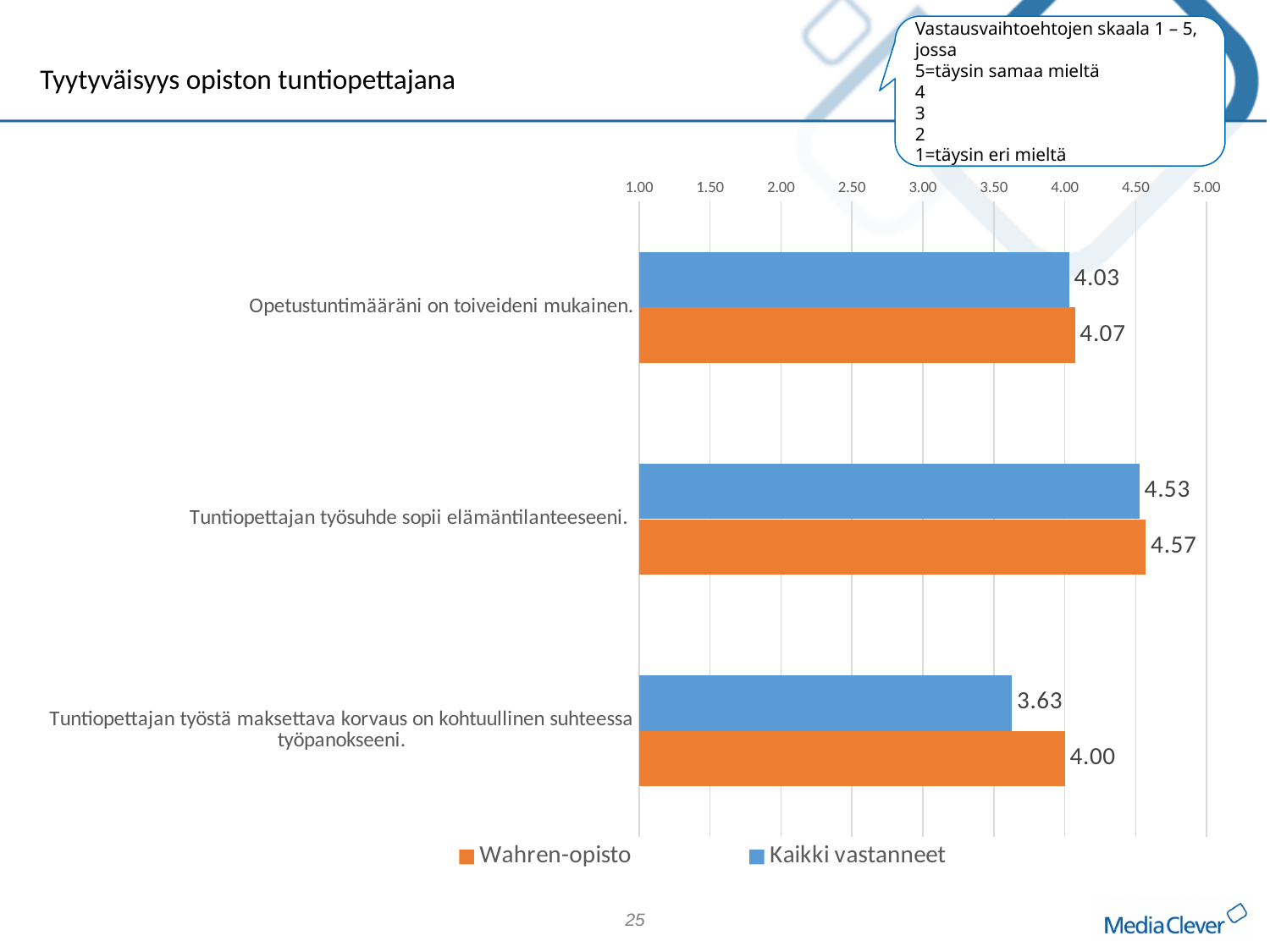
How many series does the legend list? 2 What is the difference between the Wahren-opisto and Kaikki vastanneet values for "Tuntiopettajan työstä maksettava korvaus on kohtuullinen suhteessa työpanokseeni."? 0.37 How many categories are shown on the chart? 3 Which category has the lowest Kaikki vastanneet value? Tuntiopettajan työstä maksettava korvaus on kohtuullinen suhteessa työpanokseeni. What is the Wahren-opisto value for "Opetustuntimääräni on toiveideni mukainen."? 4.07 What kind of chart is shown on the slide? Bar chart Which category has the highest Wahren-opisto value? Tuntiopettajan työsuhde sopii elämäntilanteeseeni. Is the Kaikki vastanneet value for "Tuntiopettajan työstä maksettava korvaus on kohtuullinen suhteessa työpanokseeni." greater or less than 4.00? less What is the Kaikki vastanneet value for "Tuntiopettajan työstä maksettava korvaus on kohtuullinen suhteessa työpanokseeni."? 3.63 What is the title of the slide? Tyytyväisyys opiston tuntiopettajana What is the Kaikki vastanneet value for "Tuntiopettajan työsuhde sopii elämäntilanteeseeni."? 4.53 For "Tuntiopettajan työsuhde sopii elämäntilanteeseeni.", which series has the larger value, Wahren-opisto or Kaikki vastanneet? Wahren-opisto